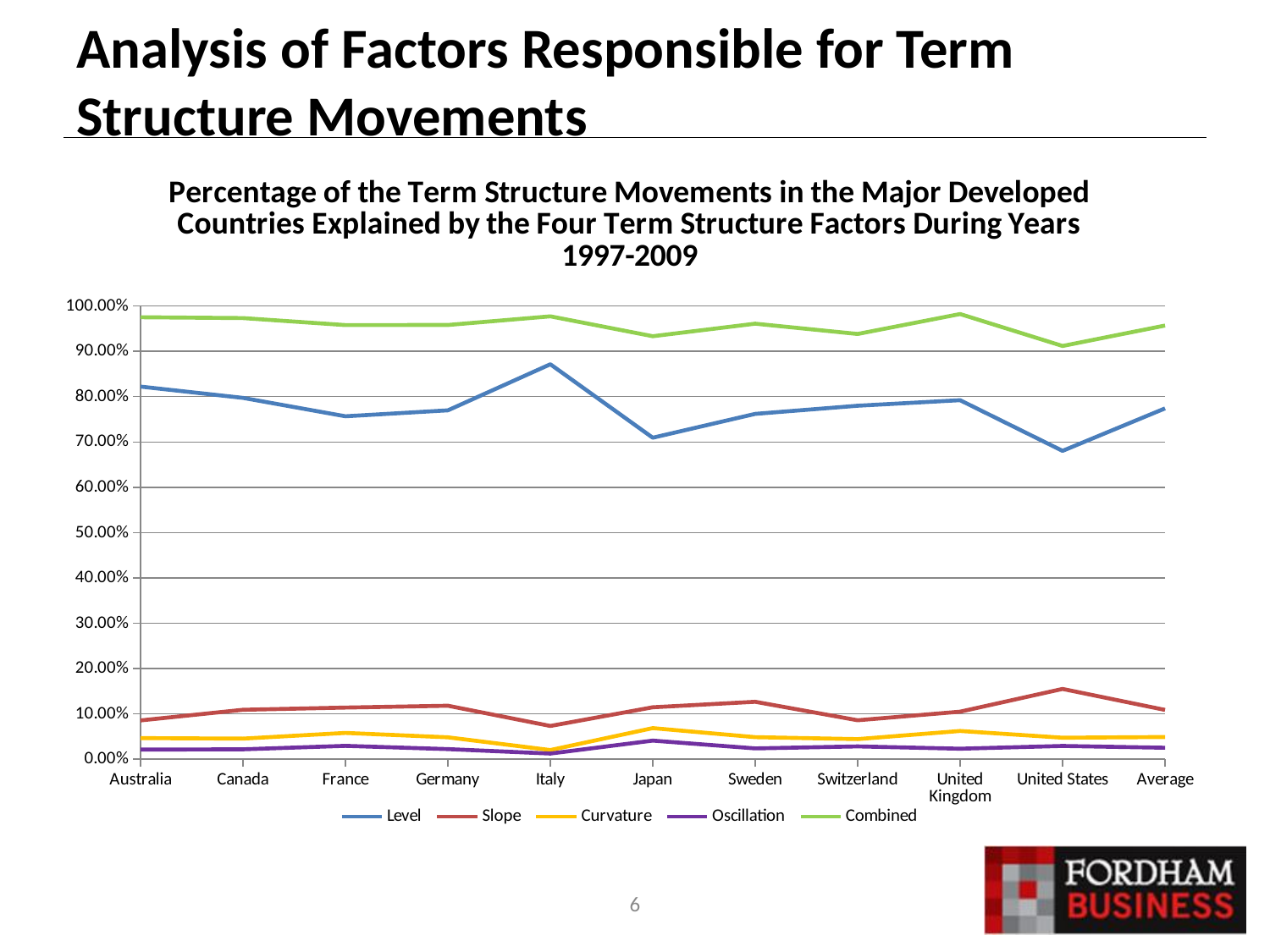
Is the Level value for the United States greater or less than 70.00%? less What kind of chart is shown on the slide? Line chart Is the Combined value for Japan greater or less than 90.00%? greater How many series does the legend list? 5 Which is larger for Italy, the Level value or the Japan Level value? Italy Which country has the lowest value for the Level series? United States Which country has the highest value for the Level series? Italy Does the Level line rise or fall from Italy to Japan? Fall How many categories are shown along the x axis? 11 Which country has the lowest value for the Combined series? United States Which country has the highest value for the Slope series? United States Is the Level value for Italy greater or less than 80.00%? greater